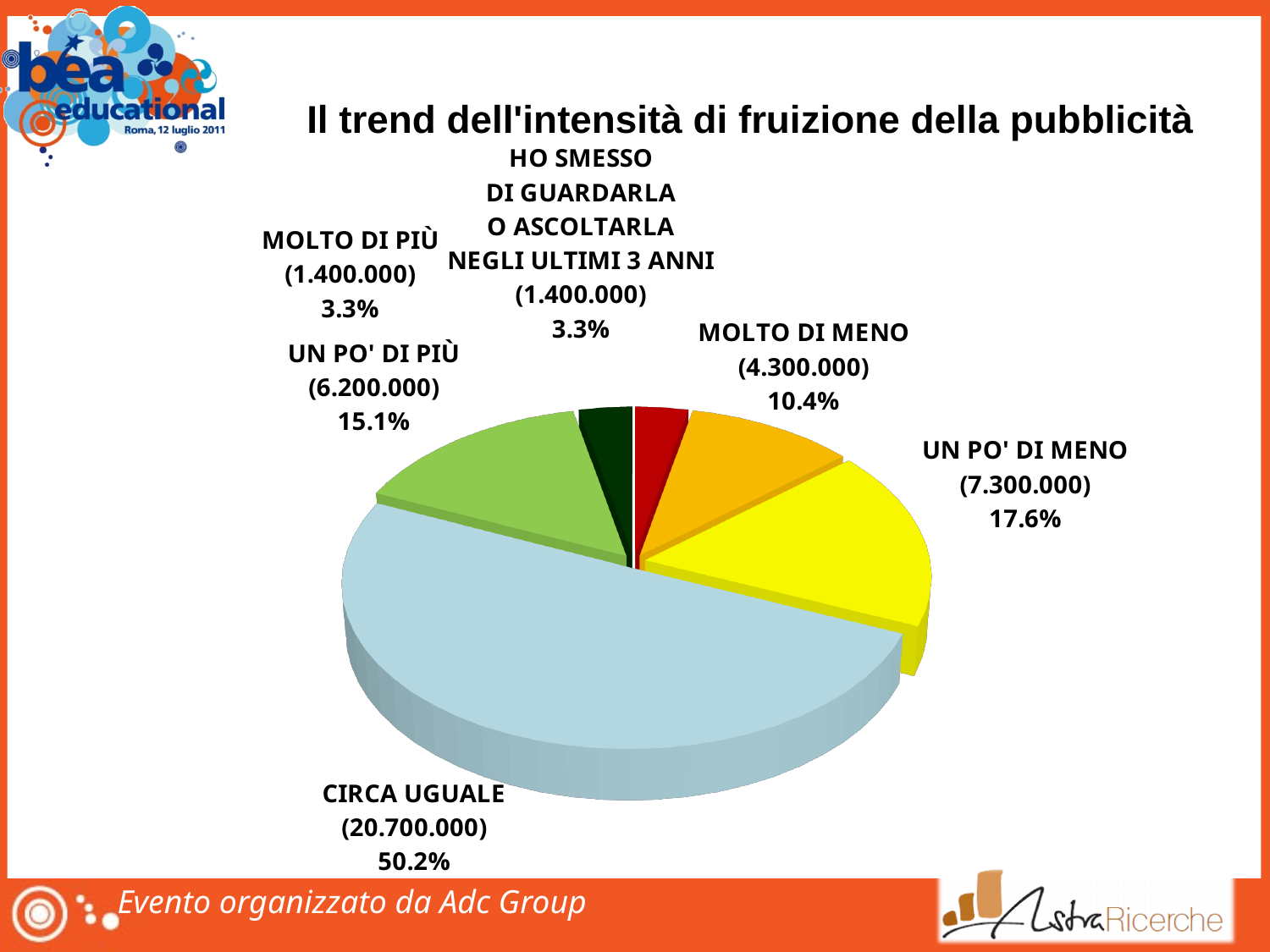
What is the difference in value between UN PO' DI MENO and MOLTO DI MENO? 3.000.000 What percentage share does MOLTO DI MENO have? 10.4% What percentage share does MOLTO DI PIÙ have? 3.3% What colour is the CIRCA UGUALE slice? light blue Which category has the largest slice of the pie? CIRCA UGUALE What is the title of the chart? Il trend dell'intensità di fruizione della pubblicità Which is larger, the share for UN PO' DI PIÙ or the share for MOLTO DI MENO? UN PO' DI PIÙ What is the value shown for UN PO' DI MENO? 7.300.000 What percentage share does CIRCA UGUALE have? 50.2% How many slices does the pie chart have? 6 What type of chart is shown on the slide? pie chart What is the value shown for UN PO' DI PIÙ? 6.200.000